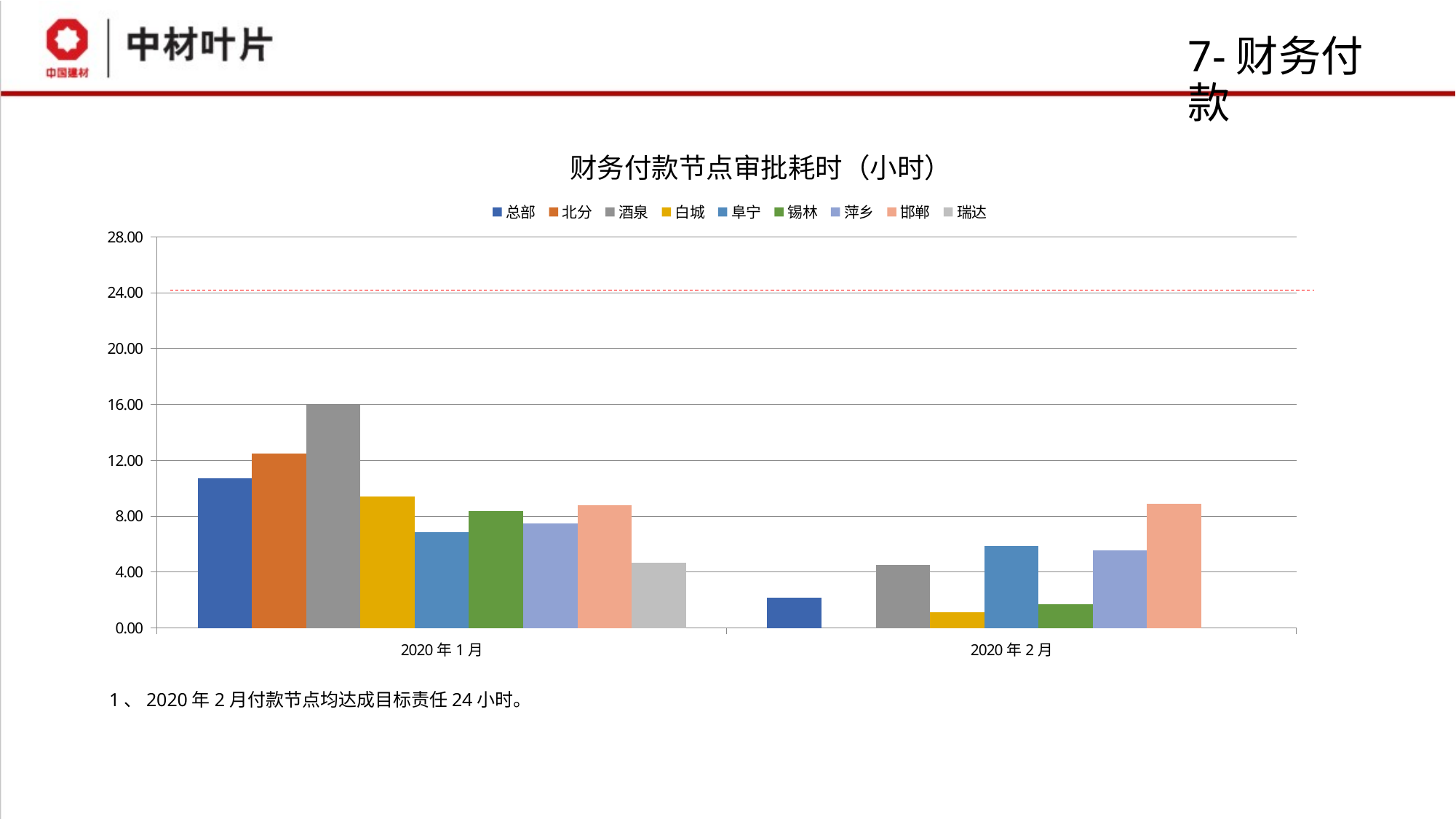
Which series has the highest value in 2020年2月? 邯郸 Which is larger in 2020年1月: 总部 or 白城? 总部 Which series has the highest value in 2020年1月? 酒泉 How many series does the legend list? 9 Which series has the lowest value in 2020年2月? 白城 Is the value for 北分 in 2020年1月 greater or less than 12.00? greater What is the title of the chart? 财务付款节点审批耗时（小时） Does the value for 总部 rise or fall from 2020年1月 to 2020年2月? fall How many categories (months) are shown on the x axis? 2 Which series has the lowest value in 2020年1月? 瑞达 Is the value for 总部 in 2020年2月 greater or less than 4.00? less What kind of chart is shown on the slide? bar chart